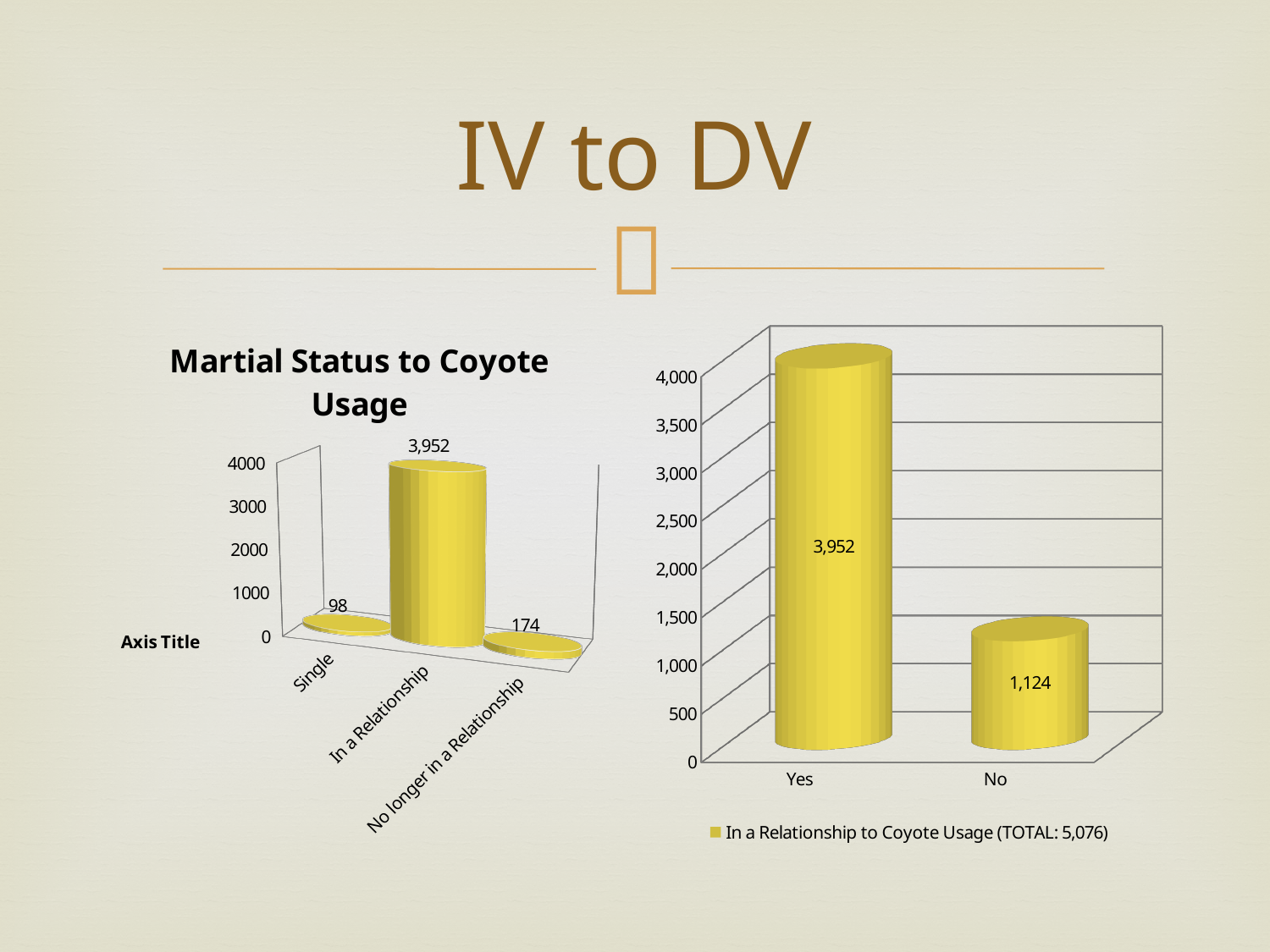
In the chart on the right, what is the value for 'Yes'? 3,952 In the 'Martial Status to Coyote Usage' chart, what is the value for 'No longer in a Relationship'? 174 In the 'Martial Status to Coyote Usage' chart, which category has the lowest value? Single In the 'Martial Status to Coyote Usage' chart, which category has the highest value? In a Relationship What kind of chart is the chart on the right? Bar chart What is the legend entry of the chart on the right? In a Relationship to Coyote Usage (TOTAL: 5,076) In the 'Martial Status to Coyote Usage' chart, what is the difference between 'No longer in a Relationship' and 'Single'? 76 In the 'Martial Status to Coyote Usage' chart, what is the value for 'Single'? 98 How many categories are shown in the 'Martial Status to Coyote Usage' chart? 3 In the chart on the right, what is the difference between 'Yes' and 'No'? 2,828 In the chart on the right, what is the value for 'No'? 1,124 In the 'Martial Status to Coyote Usage' chart, what is the value for 'In a Relationship'? 3,952